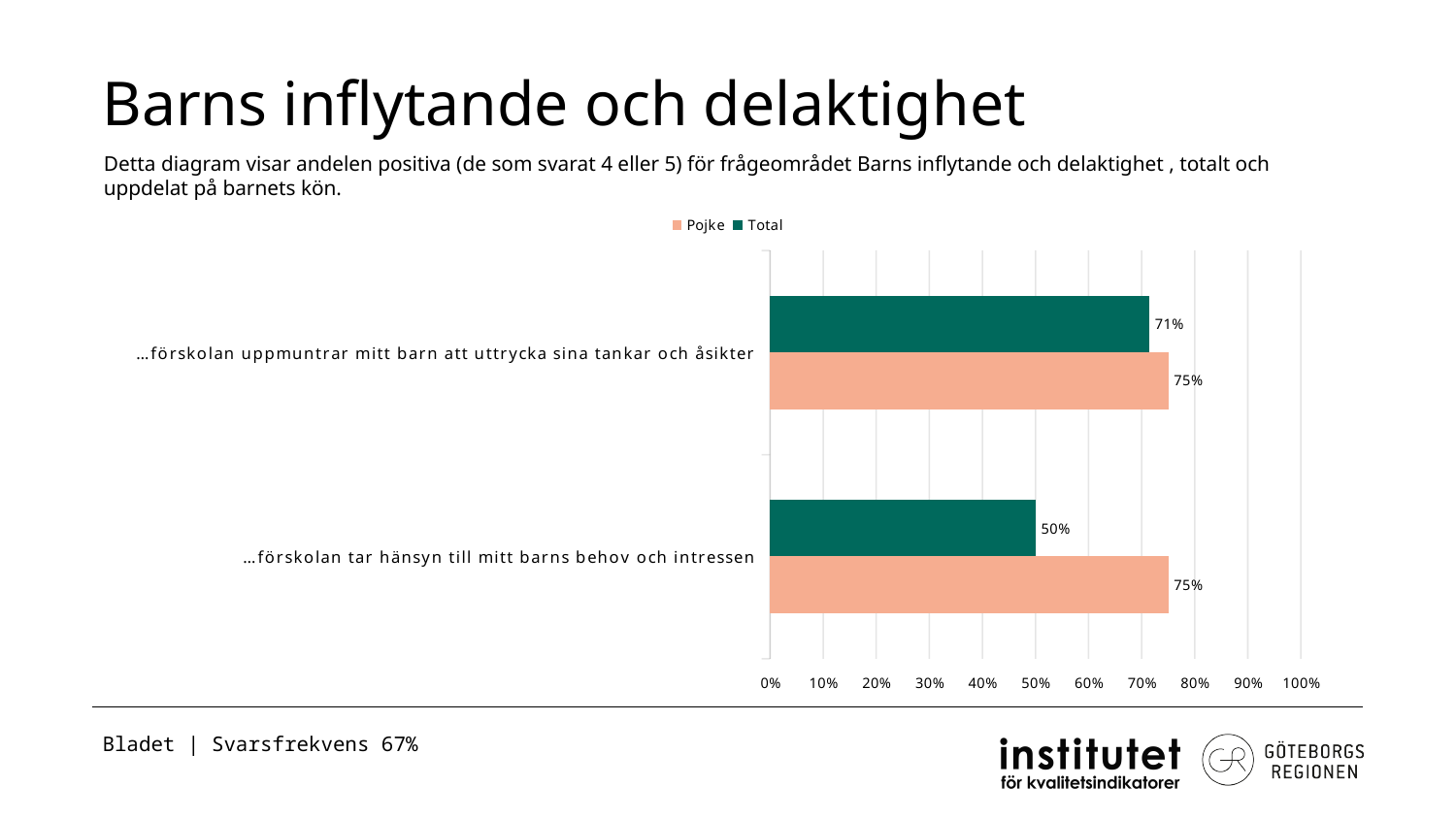
How many categories are shown in the chart? 2 What is the Total value for "…förskolan uppmuntrar mitt barn att uttrycka sina tankar och åsikter"? 71% What is the difference between the Pojke and Total values for "…förskolan uppmuntrar mitt barn att uttrycka sina tankar och åsikter"? 4% Which is larger for "…förskolan tar hänsyn till mitt barns behov och intressen": the Pojke value or the Total value? Pojke What is the difference between the Pojke and Total values for "…förskolan tar hänsyn till mitt barns behov och intressen"? 25% Which series is shown in dark green in the legend? Total How many series does the legend list? 2 What is the Pojke value for "…förskolan uppmuntrar mitt barn att uttrycka sina tankar och åsikter"? 75% What is the Total value for "…förskolan tar hänsyn till mitt barns behov och intressen"? 50% What is the Pojke value for "…förskolan tar hänsyn till mitt barns behov och intressen"? 75% What kind of chart is shown on the slide? Bar chart Which category has the lowest Total value? …förskolan tar hänsyn till mitt barns behov och intressen